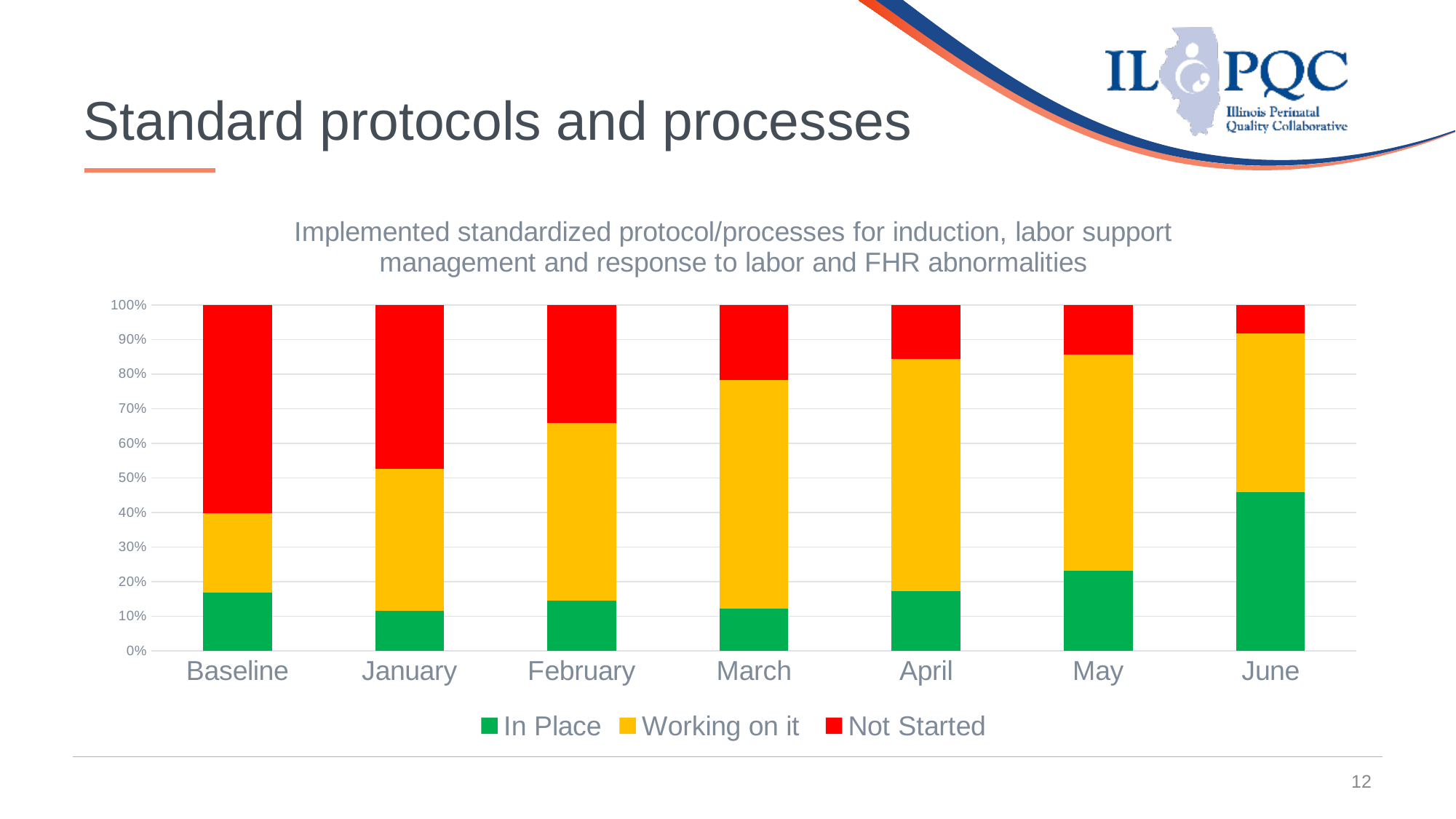
How many categories are shown along the x axis? 7 Which category has the largest Not Started share? Baseline Which category has the smallest Not Started share? June Which category has the highest In Place share? June Does the Not Started share rise or fall from Baseline to June? Fall Is the In Place value for January greater or less than 20%? less Which is larger, the In Place share for May or for Baseline? May What is the total of the stacked bar for March? 100% What kind of chart is shown on the slide? Stacked bar chart Which colour represents the Working on it series in the legend? Yellow Is the In Place value for June greater or less than 40%? greater How many series does the legend list? 3